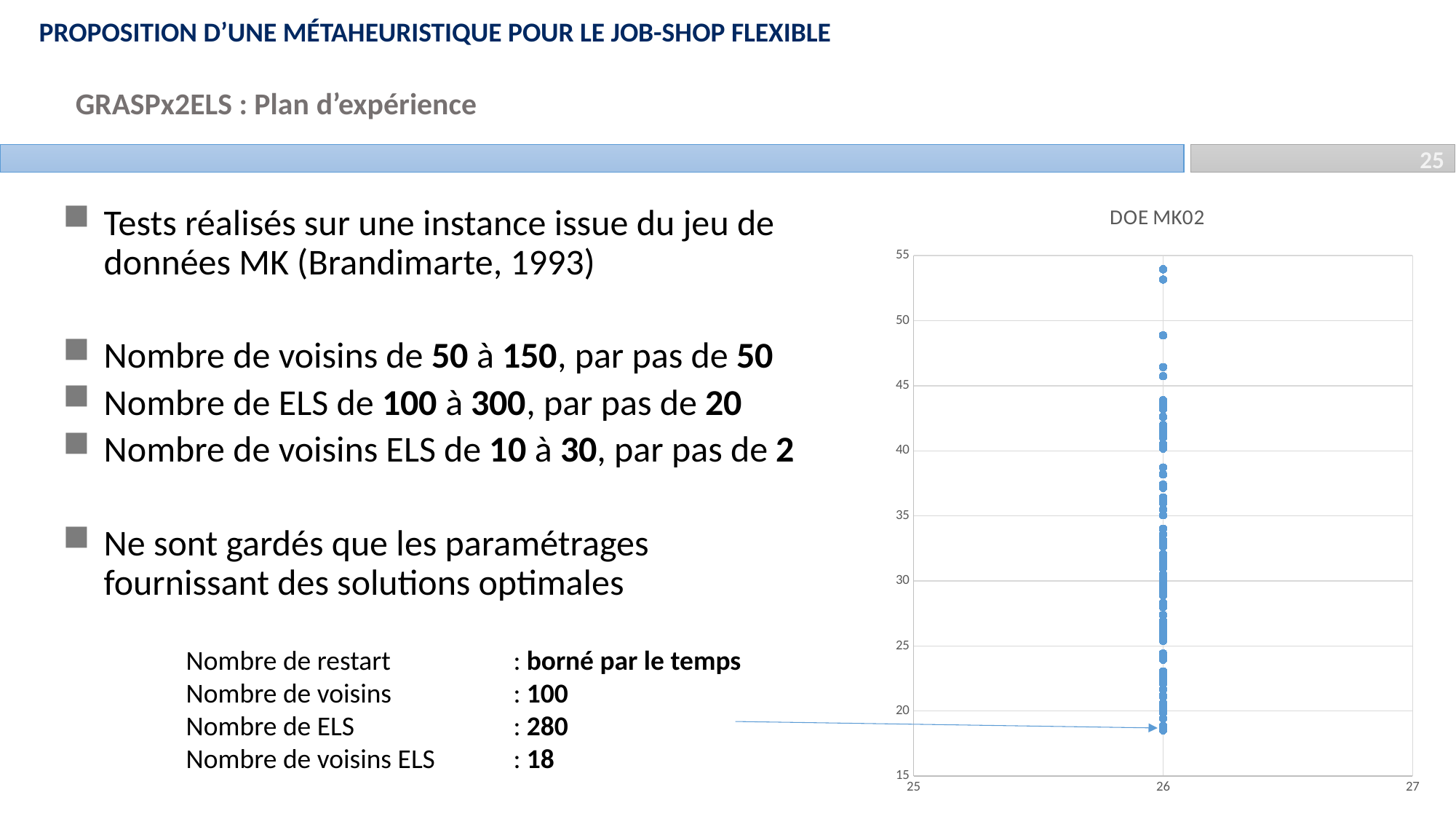
In the DOE MK02 chart, is the lowest plotted point greater or less than 20? less In the DOE MK02 chart, is the highest plotted point greater or less than 50? greater In the DOE MK02 chart, is the highest plotted point greater or less than 55? less What is the maximum value shown on the x axis of the DOE MK02 chart? 27 What is the minimum value shown on the x axis of the DOE MK02 chart? 25 What is the maximum value shown on the y axis of the DOE MK02 chart? 55 What is the title of the chart on the slide? DOE MK02 What kind of chart is shown on the slide? scatter chart In the DOE MK02 chart, at which x-axis value are all the points plotted? 26